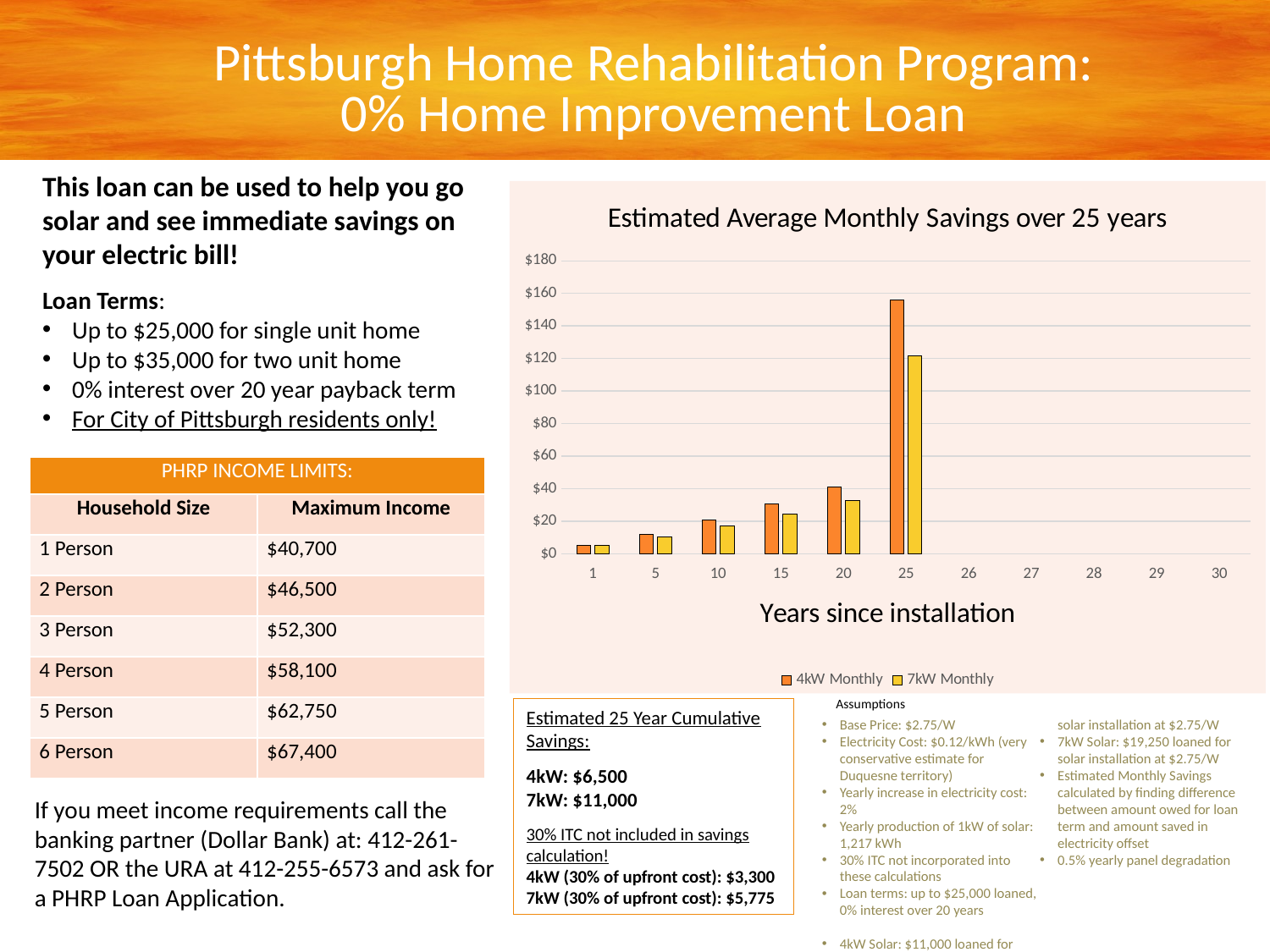
At which year since installation is the 7kW Monthly savings value highest? 25 At which year since installation is the 4kW Monthly savings value highest? 25 Do the 4kW Monthly values rise or fall from year 1 to year 25? rise What kind of chart is shown on the slide? bar chart Is the 4kW Monthly value at year 25 greater or less than $140? greater What are the two series named in the chart's legend? 4kW Monthly and 7kW Monthly What is the title of the chart? Estimated Average Monthly Savings over 25 years How many series does the chart's legend list? 2 Is the 4kW Monthly value at year 20 greater or less than $60? less How many year categories are labelled on the x axis of the chart? 11 At year 25, which series has the larger value, 4kW Monthly or 7kW Monthly? 4kW Monthly Is the 7kW Monthly value at year 25 greater or less than $140? less